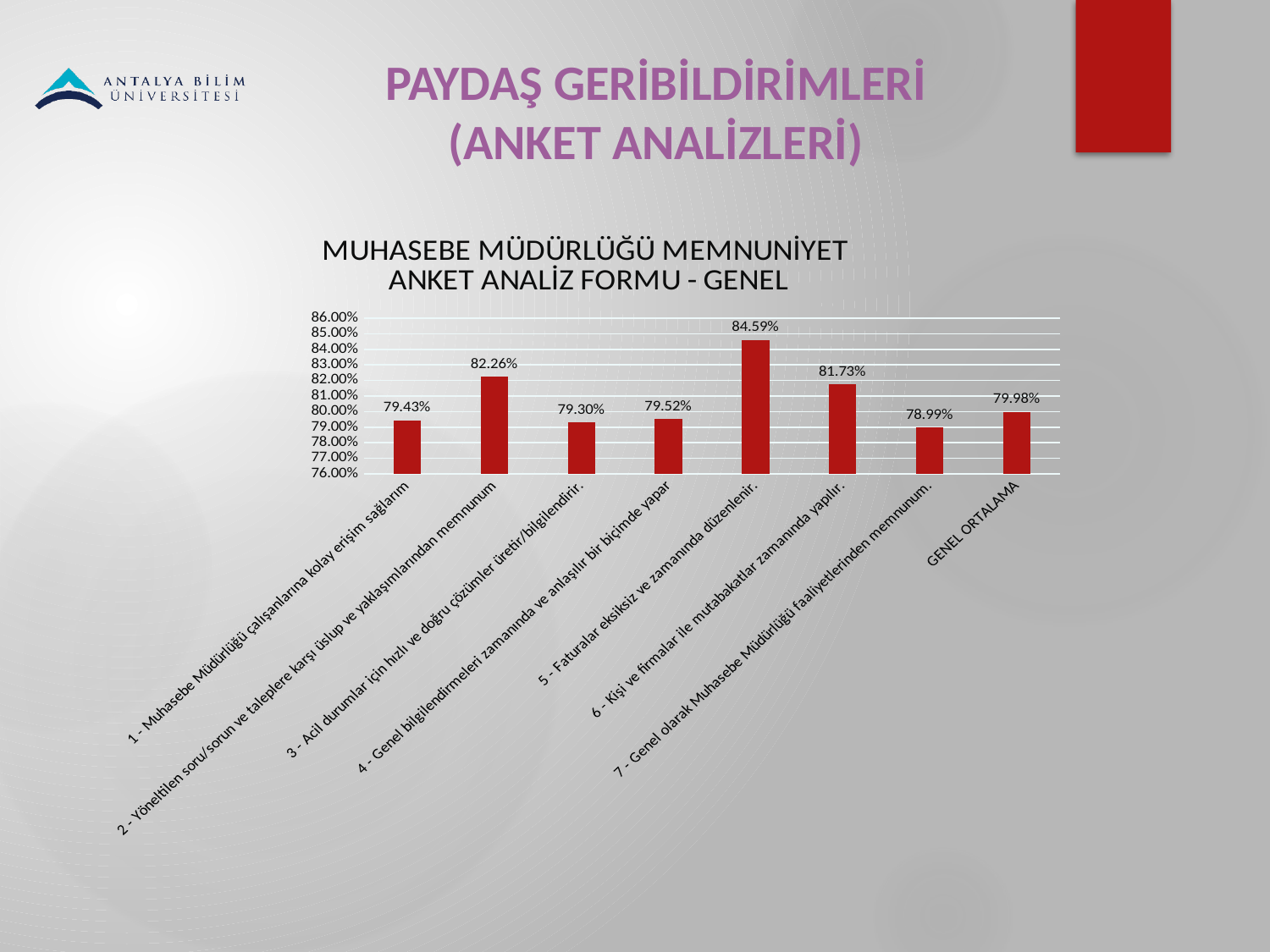
What kind of chart is shown on the slide? Bar chart Which category has the highest value? 5 - Faturalar eksiksiz ve zamanında düzenlenir. What is the value for category 7 (Genel olarak Muhasebe Müdürlüğü faaliyetlerinden memnunum.)? 78.99% How many categories are shown on the x axis? 8 Which is larger: the value for category 2 or the value for category 6? Category 2 (82.26%) What is the value for GENEL ORTALAMA? 79.98% What is the value for category 5 (Faturalar eksiksiz ve zamanında düzenlenir.)? 84.59% What is the value for category 2 (Yöneltilen soru/sorun ve taleplere karşı üslup ve yaklaşımlarından memnunum)? 82.26% What is the title of the chart? MUHASEBE MÜDÜRLÜĞÜ MEMNUNİYET ANKET ANALİZ FORMU - GENEL What is the difference between the value for category 5 and the value for category 7? 5.60% Which category has the lowest value? 7 - Genel olarak Muhasebe Müdürlüğü faaliyetlerinden memnunum. Is the value for category 6 (Kişi ve firmalar ile mutabakatlar zamanında yapılır.) greater or less than 80.00%? greater